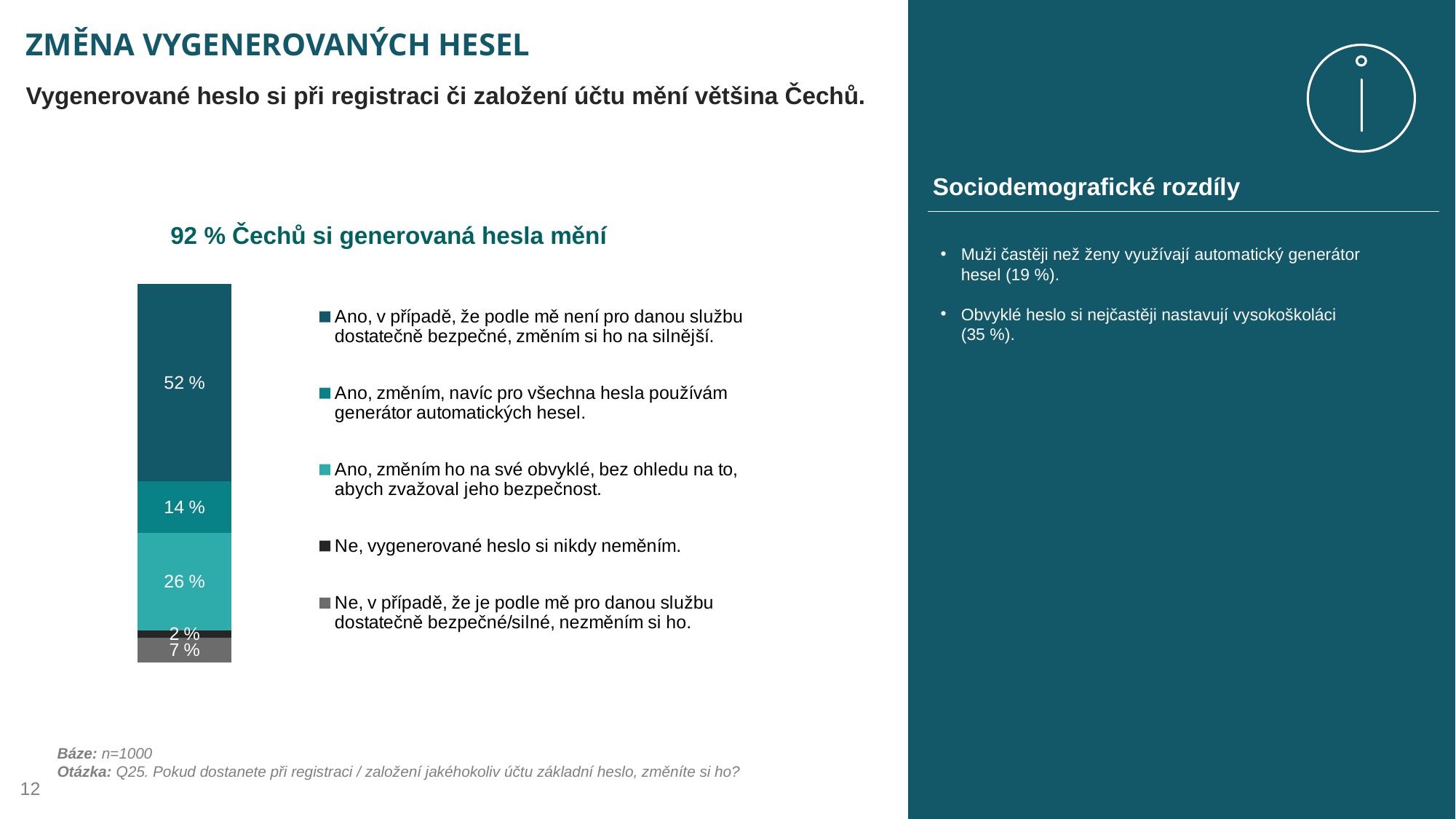
What is the difference between the share who change the password to a stronger one (52 %) and the share who change it to their usual one (26 %)? 26 % Which is larger: the share who use an automatic generator for all passwords or the share who change the password to their usual one? The share who change it to their usual one (26 %) What share of respondents change the password and use an automatic password generator for all their passwords? 14 % What share of respondents do not change the password if they consider it secure/strong enough for the service? 7 % What type of chart is shown on the slide? Stacked bar chart How many segments does the stacked bar contain? 5 What share of respondents change the generated password to a stronger one if they think it is not secure enough for the service? 52 % Which answer option has the largest share in the stacked bar? Ano, v případě, že podle mě není pro danou službu dostatečně bezpečné, změním si ho na silnější. Which answer option has the smallest share in the stacked bar? Ne, vygenerované heslo si nikdy neměním. What share of respondents never change a generated password? 2 % How many entries does the chart legend list? 5 What share of respondents change the generated password to their usual one regardless of security? 26 %